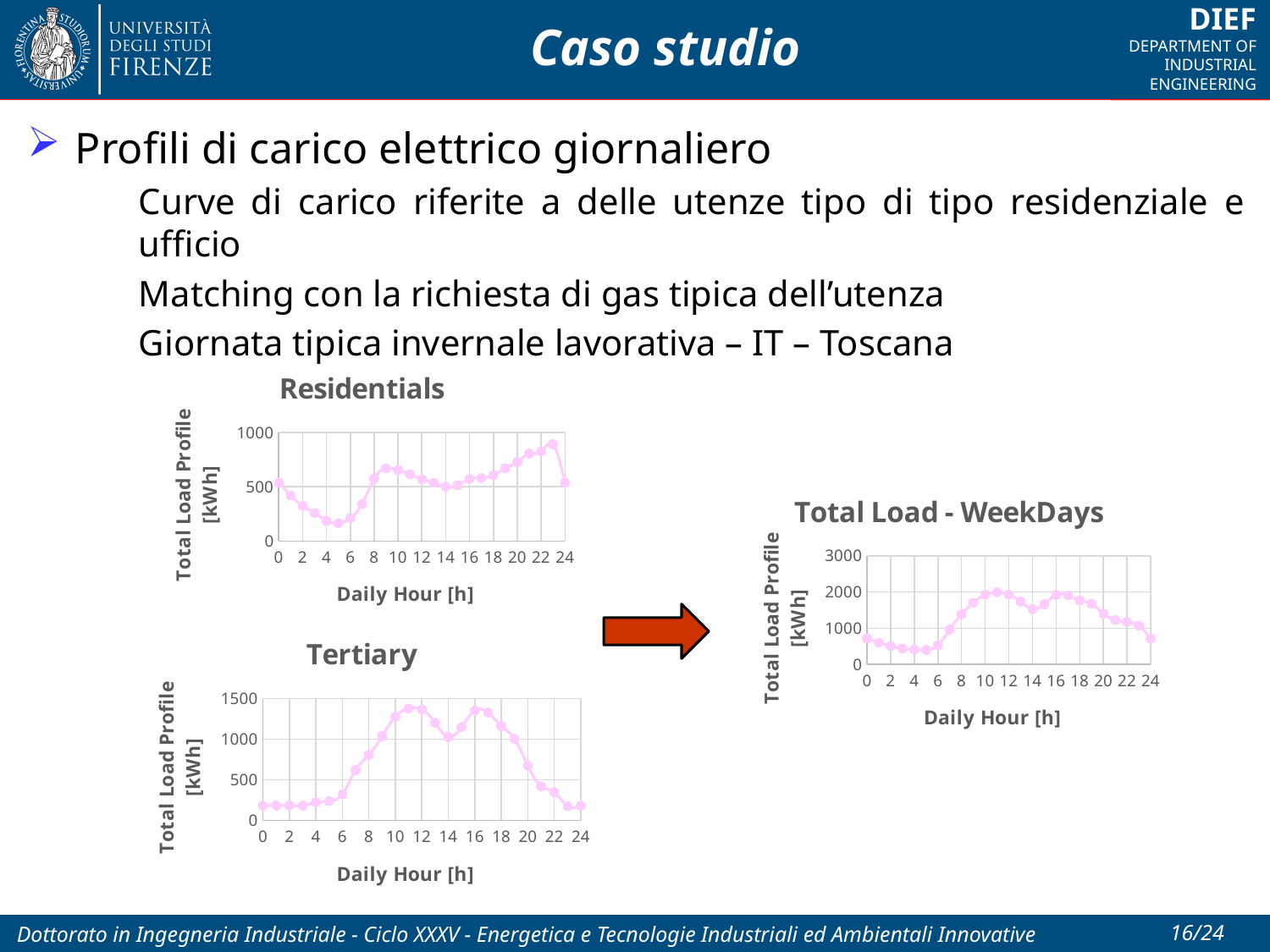
In the Total Load - WeekDays chart, which is larger: the value at hour 2 or the value at hour 12? hour 12 In the Tertiary chart, which is larger: the value at hour 12 or the value at hour 22? hour 12 In the Total Load - WeekDays chart, is the value at hour 12 greater or less than 1000? greater In the Tertiary chart, is the value at hour 2 greater or less than 500? less In the Residentials chart, is the value at hour 5 greater or less than 500? less In the Residentials chart, at which daily hour is the load profile highest? 23 In the Tertiary chart, do the values rise or fall between hour 18 and hour 22? fall What is the label of the y-axis on the Total Load - WeekDays chart? Total Load Profile [kWh] In the Residentials chart, at which daily hour is the load profile lowest? 5 What kind of chart is the Residentials chart? line chart